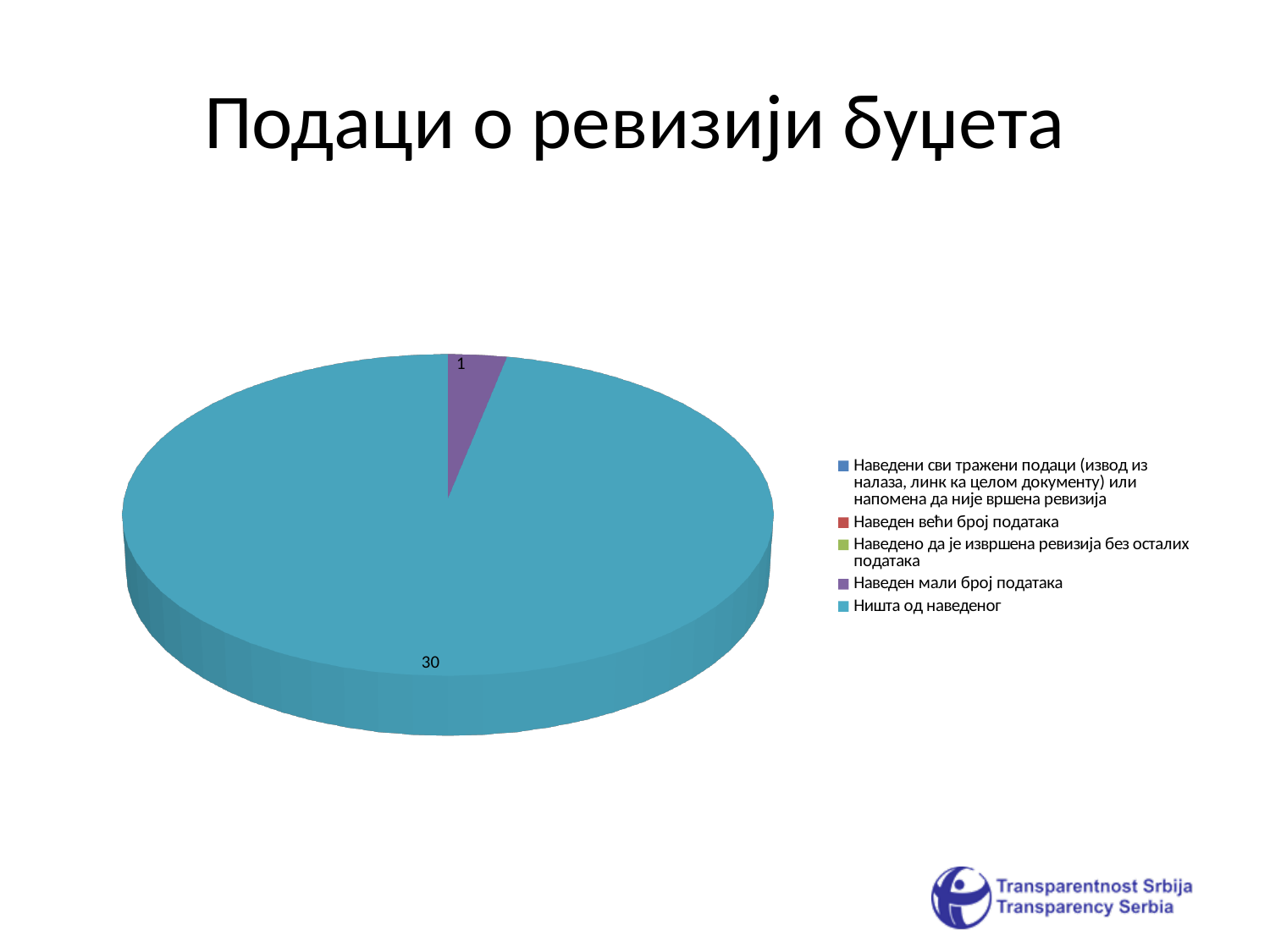
What is the total of the two labelled slices in the pie? 31 What is the title of the chart? Подаци о ревизији буџета How many entries does the legend list? 5 What kind of chart is shown on the slide? pie chart What is the difference between the values for "Ништа од наведеног" and "Наведен мали број података"? 29 What value is shown for the slice "Ништа од наведеног"? 30 How many slices with data labels are visible in the pie? 2 What colour is the slice for "Наведен мали број података"? purple What value is shown for the slice "Наведен мали број података"? 1 Which is larger, the value for "Ништа од наведеног" or the value for "Наведен мали број података"? Ништа од наведеног Which category has the largest slice of the pie? Ништа од наведеног